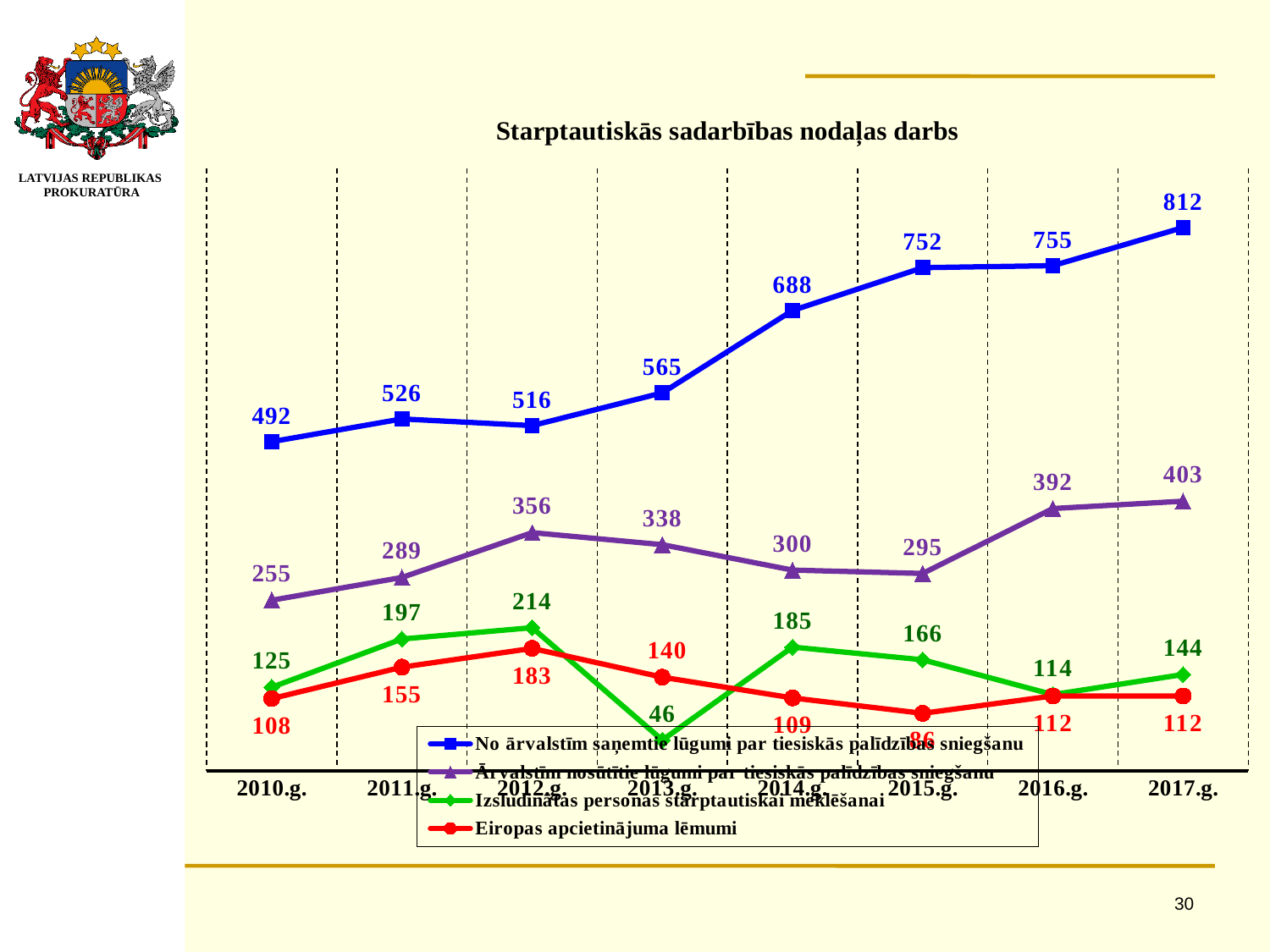
In which year does the red series (Eiropas apcietinājuma lēmumi) reach its lowest value? 2015.g. What type of chart is shown on the slide? line chart In which year does the green series (Izsludinātās personas starptautiskai meklēšanai) reach its highest value? 2012.g. What is the difference between the blue series values in 2017.g. and 2010.g.? 320 What is the value of the green series (Izsludinātās personas starptautiskai meklēšanai) in 2013.g.? 46 How many series does the legend list? 4 Which is larger in 2014.g.: the green series (Izsludinātās personas starptautiskai meklēšanai) or the red series (Eiropas apcietinājuma lēmumi)? green series (185) Does the blue series (No ārvalstīm saņemtie lūgumi par tiesiskās palīdzības sniegšanu) generally rise or fall from 2010.g. to 2017.g.? rise What is the title of the chart? Starptautiskās sadarbības nodaļas darbs What is the value of the purple series (Ārvalstīm nosūtītie lūgumi par tiesiskās palīdzības sniegšanu) in 2012.g.? 356 What is the value of the blue series (No ārvalstīm saņemtie lūgumi par tiesiskās palīdzības sniegšanu) in 2017.g.? 812 How many years are shown on the x axis? 8